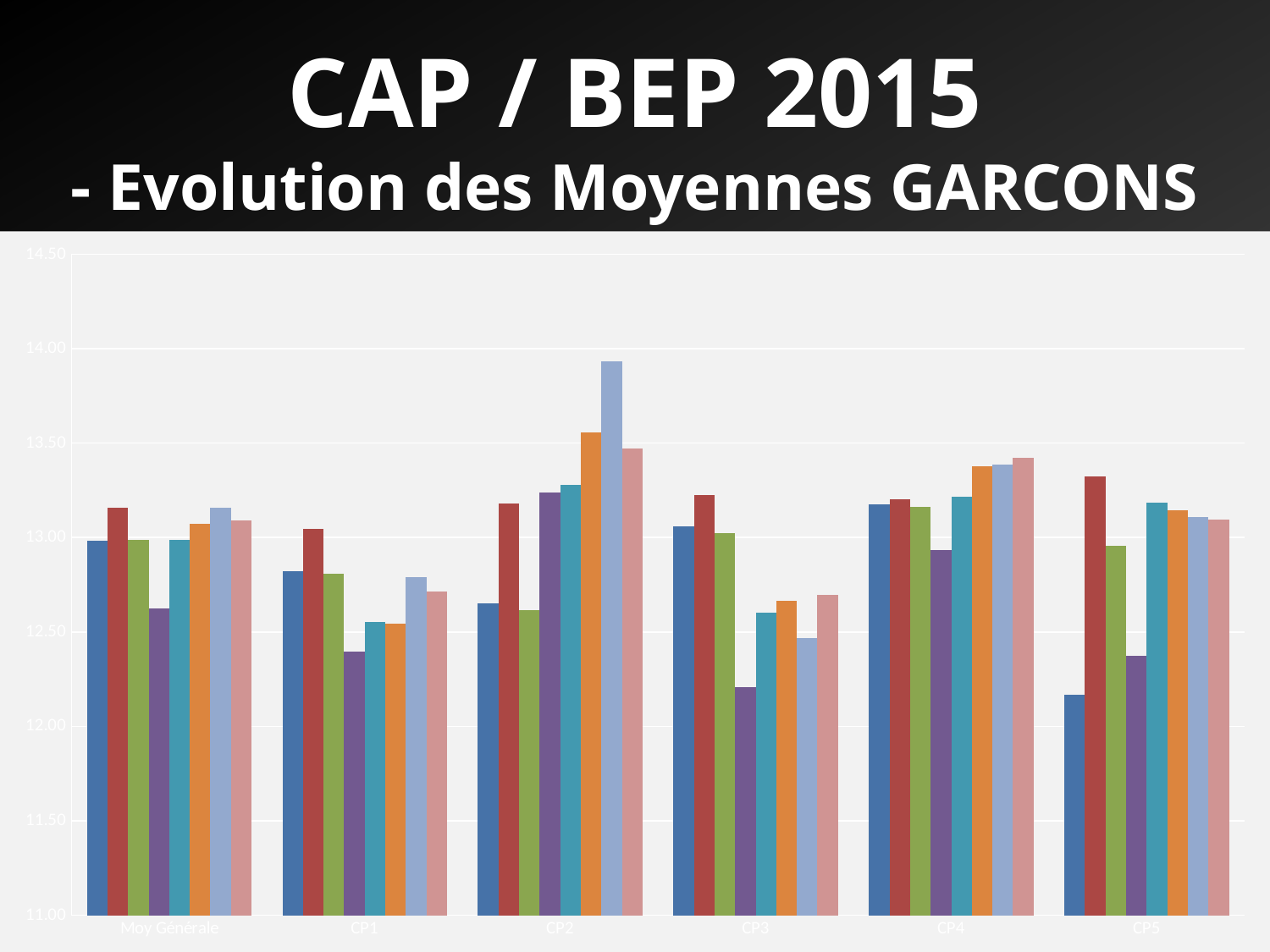
Is the purple bar in the CP1 group greater or less than 13.00? less How many categories are shown along the x axis? 6 Which is larger: the orange bar in the CP2 group or the orange bar in the CP3 group? CP2 Is the tallest bar in the CP2 group greater or less than 13.50? greater How many bars are plotted for each category? 8 Is the first (dark blue) bar in the CP5 group greater or less than 12.50? less Which is larger: the first (dark blue) bar in the CP4 group or the first (dark blue) bar in the CP5 group? CP4 Which category contains the tallest bar on the chart? CP2 What kind of chart is shown on the slide? bar chart What is the highest value shown on the vertical axis? 14.50 What is the title of the slide containing the chart? CAP / BEP 2015 - Evolution des Moyennes GARCONS